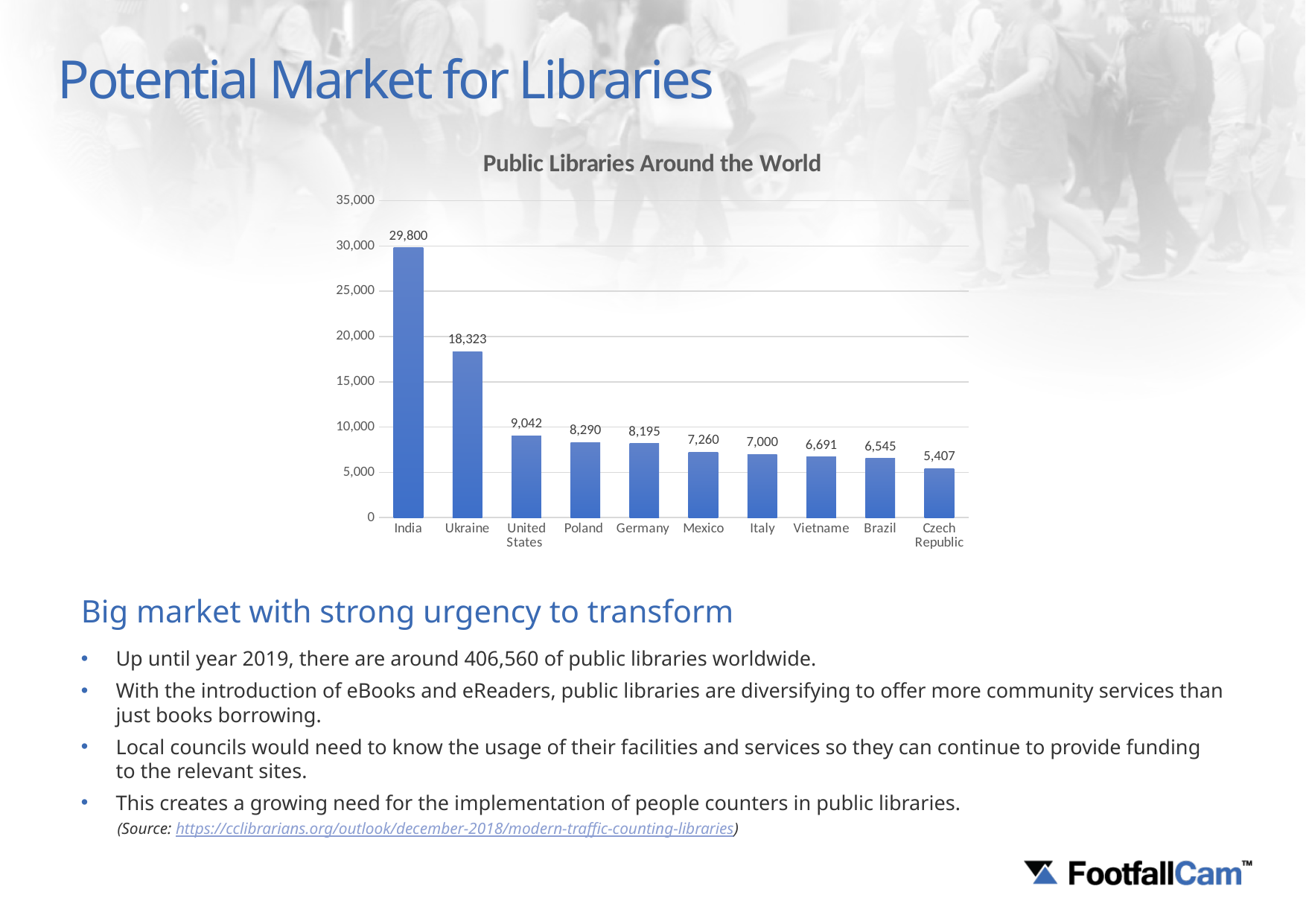
Which has a larger value, Mexico or Italy? Mexico Which country has the highest number of public libraries in the chart? India What kind of chart is shown on the slide? Bar chart What is the difference between the values for Poland and Germany? 95 What is the difference between the values for India and Ukraine? 11,477 What is the value for Ukraine in the chart? 18,323 What is the value for the Czech Republic in the chart? 5,407 What is the value for Germany in the chart? 8,195 How many countries are shown in the chart? 10 What is the value for India in the Public Libraries Around the World chart? 29,800 Which country has the lowest number of public libraries in the chart? Czech Republic What is the title of the chart? Public Libraries Around the World